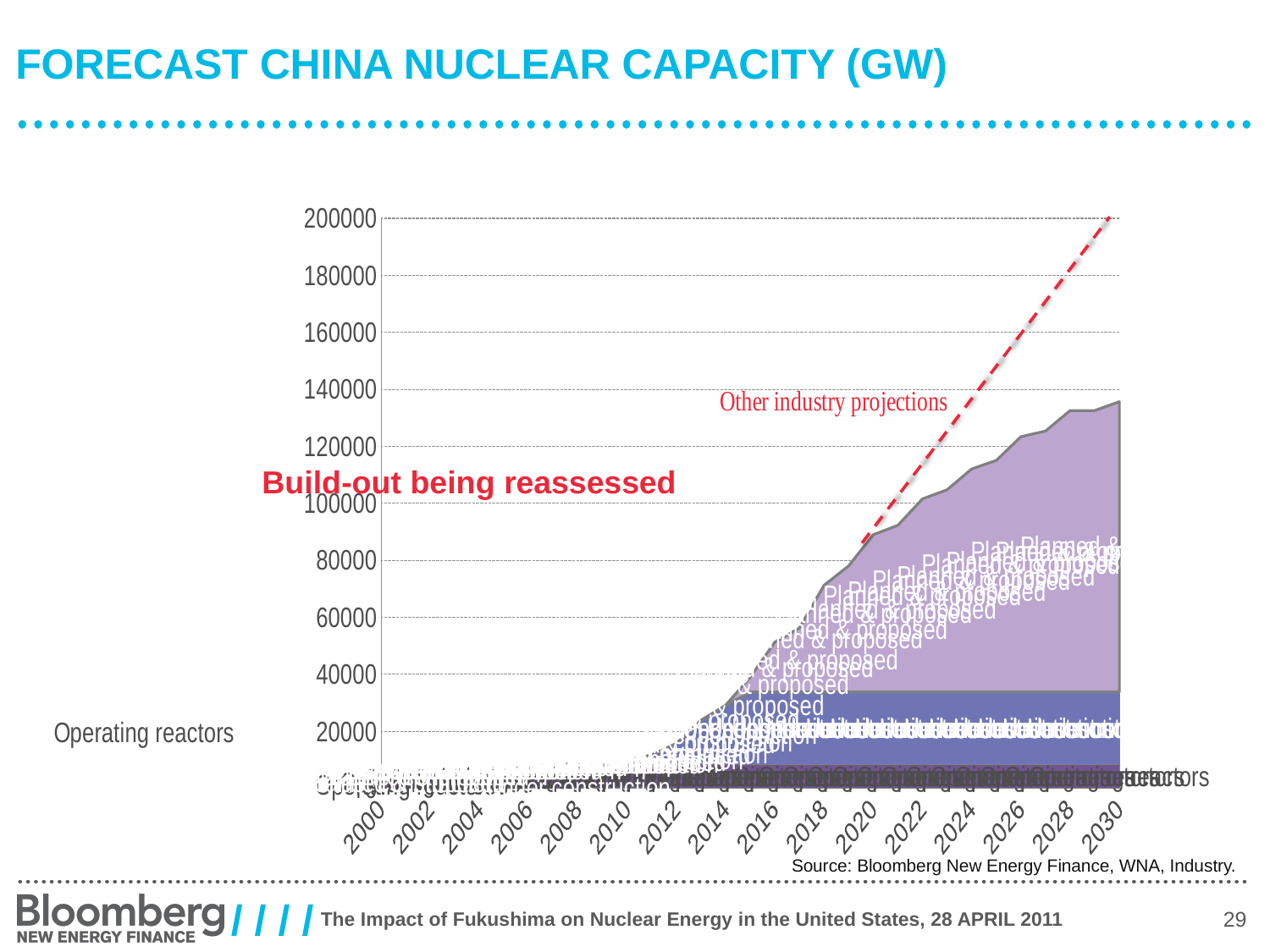
What is the highest value shown on the y axis? 200000 Is the total forecast capacity in 2010 greater or less than 20000? less What kind of chart is shown on the slide? Stacked area chart What is the title of the chart on the slide? FORECAST CHINA NUCLEAR CAPACITY (GW) What is the first year shown on the x axis? 2000 What is the last year shown on the x axis? 2030 Is the total forecast capacity in 2030 greater or less than 140000? less Is the total forecast capacity in 2020 greater or less than 100000? less Does the total forecast capacity rise or fall from 2000 to 2030? Rise